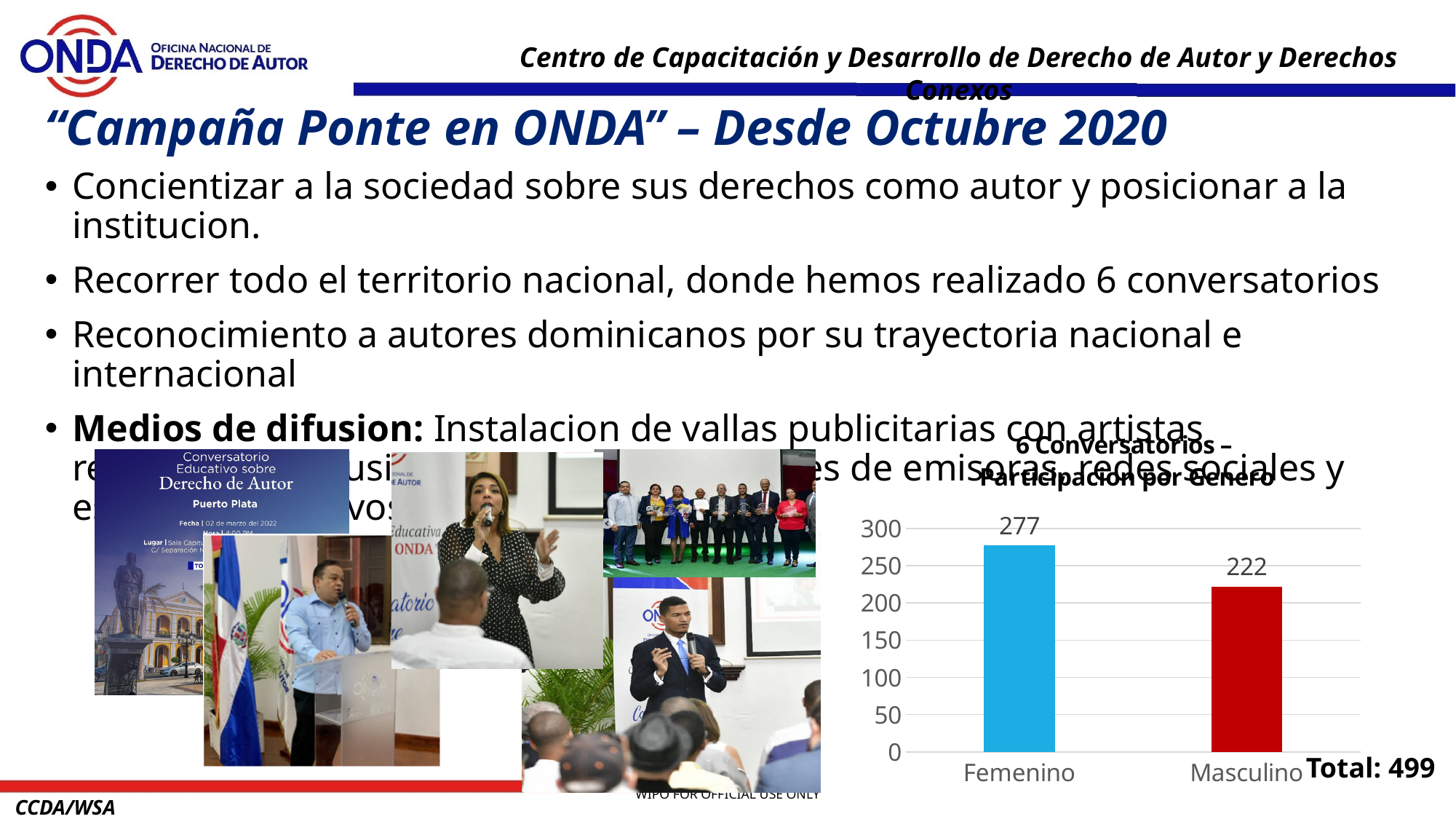
What kind of chart is shown on the slide? bar chart What is the value for Femenino in the chart? 277 What is the total shown next to the chart? Total: 499 Which category has the lowest value in the chart? Masculino Is the value for Femenino greater or less than 250? greater What is the value for Masculino in the chart? 222 How many categories are shown in the chart? 2 What is the difference between the Femenino and Masculino values? 55 Which is larger, the value for Femenino or the value for Masculino? Femenino What colour is the Masculino bar? red Which category has the highest value in the chart? Femenino Is the value for Masculino greater or less than 250? less